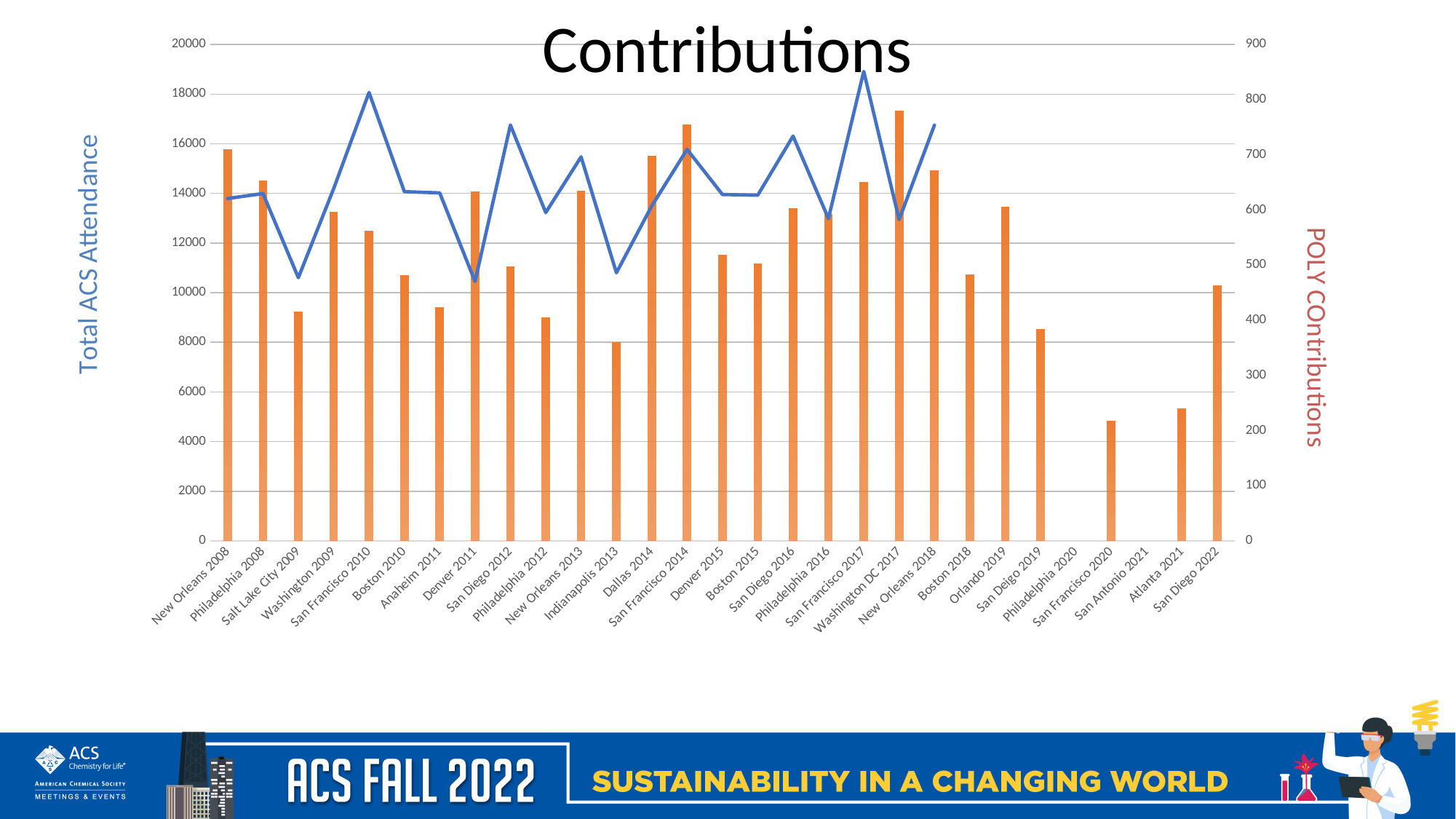
Is the Total ACS Attendance value for San Francisco 2010 greater or less than 16000? greater How many meeting categories are shown along the x axis? 29 What is the title of the chart? Contributions Which has the larger POLY Contributions bar, Washington DC 2017 or Boston 2018? Washington DC 2017 Is the POLY Contributions value for Atlanta 2021 greater or less than 300? less Which meeting has the tallest POLY Contributions bar? Washington DC 2017 Is the POLY Contributions value for San Diego 2022 greater or less than 400? greater What does the left vertical axis represent? Total ACS Attendance At which meeting does the Total ACS Attendance line reach its highest point? San Francisco 2017 What kind of chart is shown on the slide? Combined bar and line chart Do the POLY Contributions bars rise or fall from Washington DC 2017 to San Diego 2019? fall